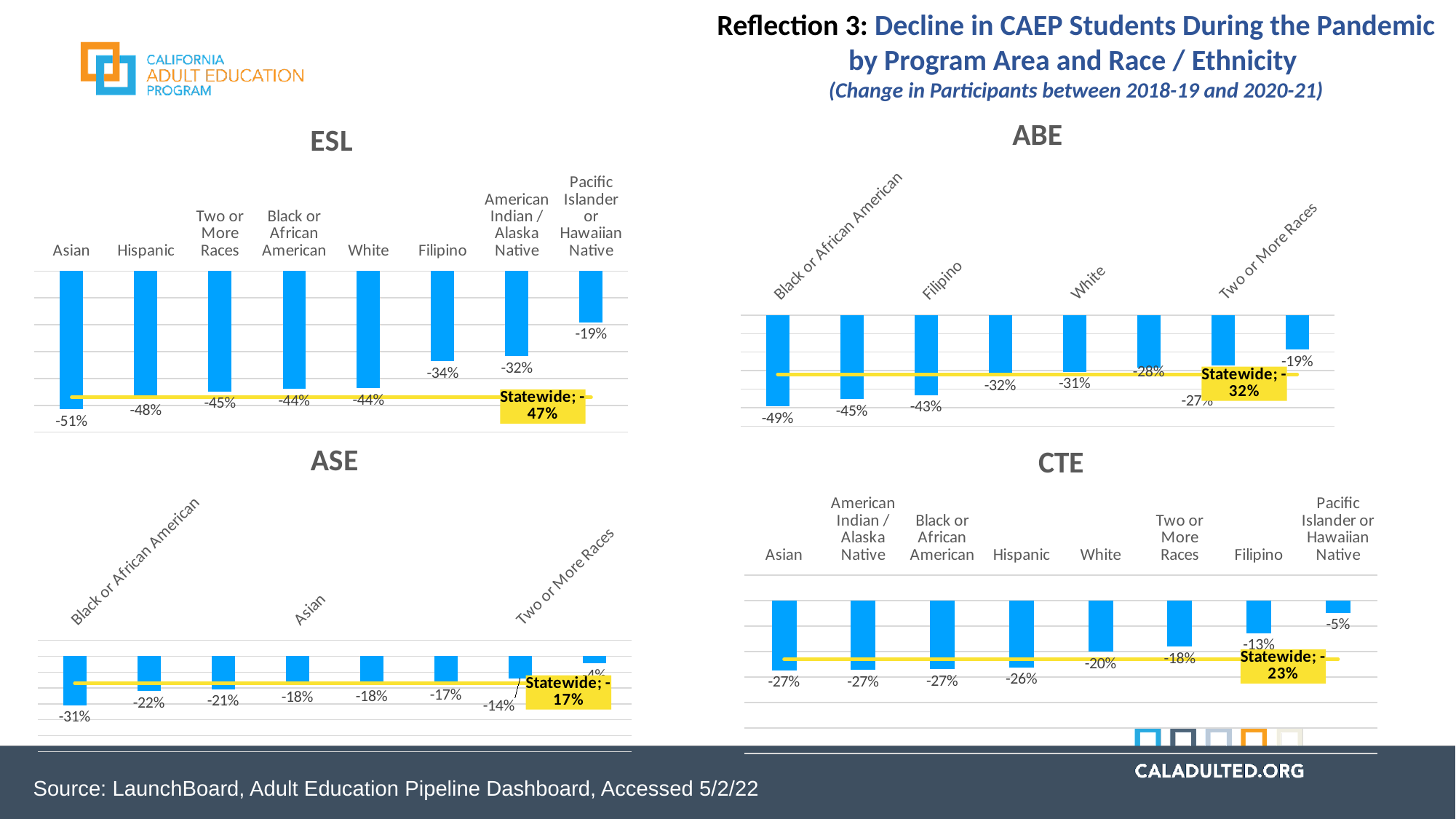
In the ESL chart, which category has the largest decline? Asian How many categories are plotted in the CTE chart? 8 In the ESL chart, what is the value for Asian? -51% In the CTE chart, which category has the smallest decline? Pacific Islander or Hawaiian Native In the ASE chart, which category has the largest decline? Black or African American In the ABE chart, what is the value for White? -31% In the ASE chart, what is the value for Two or More Races? -14% In the CTE chart, what is the value for Filipino? -13% In the ESL chart, what is the difference between the values for Hispanic and Filipino? 14 percentage points In the ABE chart, what is the Statewide value shown? -32% In the ABE chart, what is the value for Black or African American? -49% In the ESL chart, what is the value for Pacific Islander or Hawaiian Native? -19%